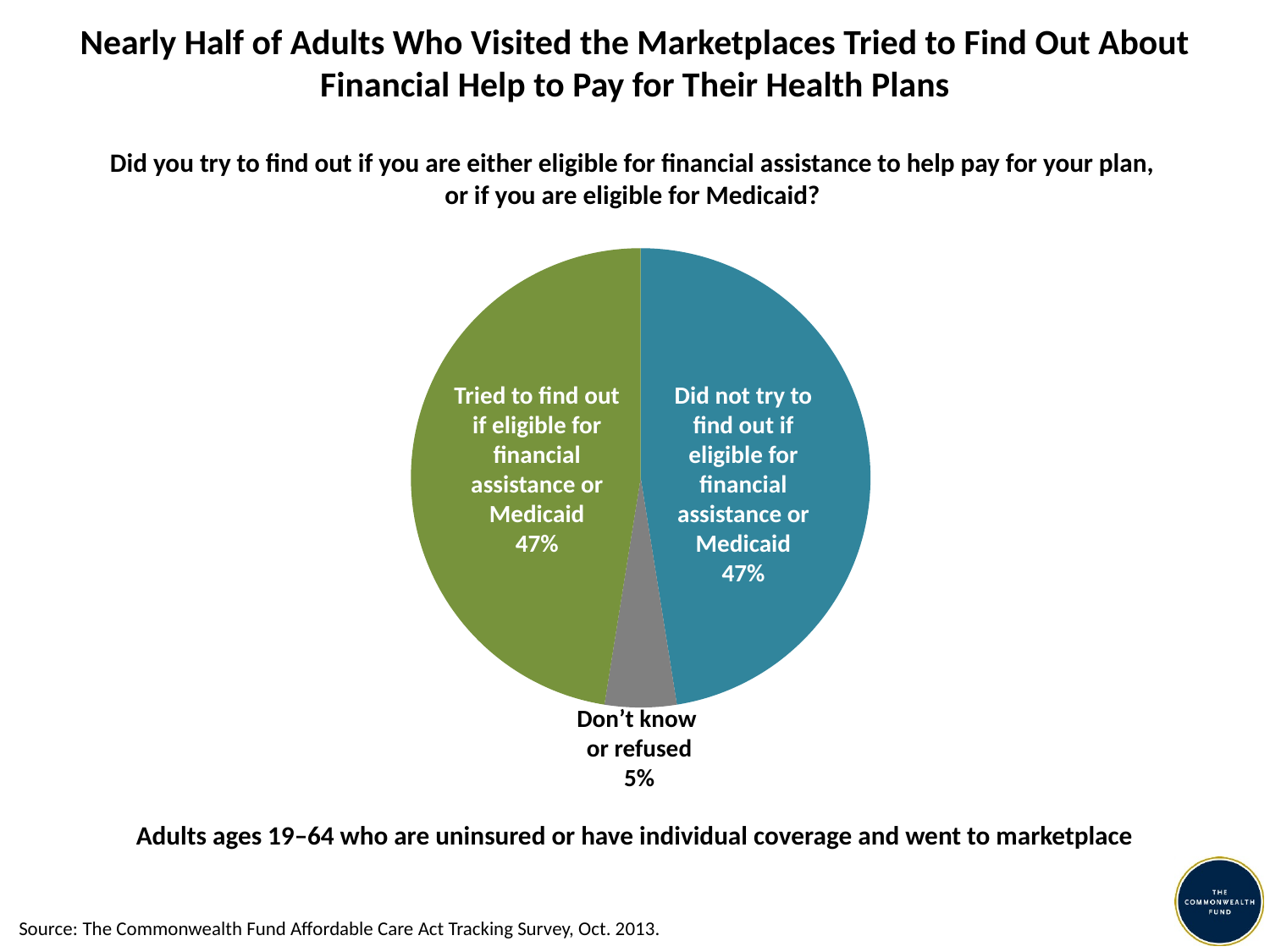
Which slice of the pie chart is the smallest? Don't know or refused What is the combined share of adults who either tried or did not try to find out if they were eligible? 94% What kind of chart is shown on the slide? Pie chart What is the difference in percentage points between the "Tried to find out" slice and the "Don't know or refused" slice? 42 percentage points Is the share of adults who tried to find out if eligible for financial assistance or Medicaid greater or less than 50%? less What colour is the "Don't know or refused" slice? Gray What percentage of adults did not try to find out if they were eligible for financial assistance or Medicaid? 47% How many slices does the pie chart have? 3 Which is larger: the share who did not try to find out if eligible, or the share who answered "Don't know or refused"? Did not try to find out if eligible What percentage of adults tried to find out if they were eligible for financial assistance or Medicaid? 47% What colour is the slice for adults who tried to find out if eligible for financial assistance or Medicaid? Green What percentage of adults answered "Don't know or refused"? 5%